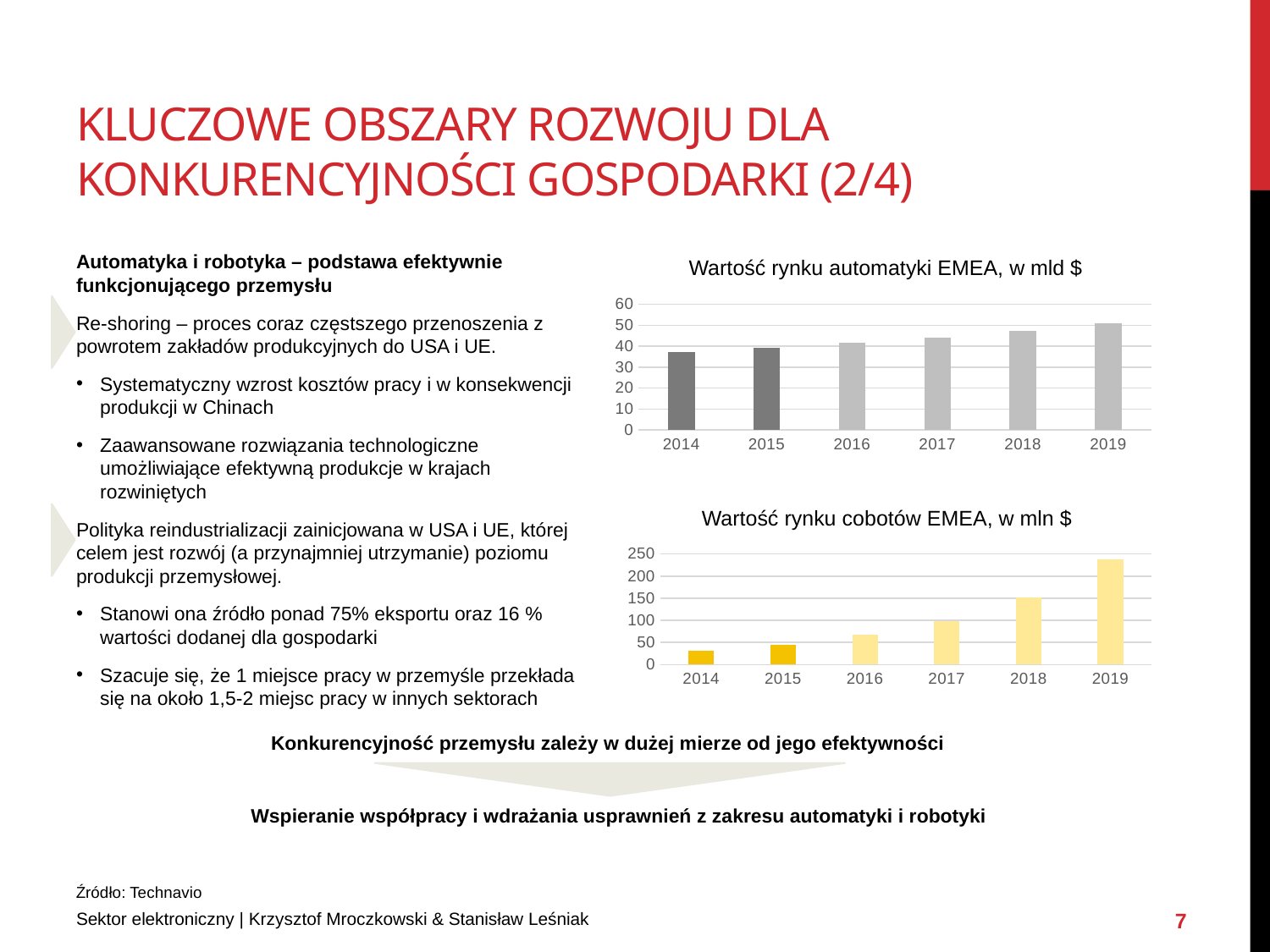
In the 'Wartość rynku automatyki EMEA, w mld $' chart, which year has the highest value? 2019 In the 'Wartość rynku cobotów EMEA, w mln $' chart, is the value for 2019 greater or less than 200? greater In the 'Wartość rynku automatyki EMEA, w mld $' chart, is the value for 2014 greater or less than 40? less In the 'Wartość rynku cobotów EMEA, w mln $' chart, is the value for 2014 greater or less than 50? less What kind of chart is the 'Wartość rynku automatyki EMEA, w mld $' chart? bar chart What is the title of the lower chart on the slide? Wartość rynku cobotów EMEA, w mln $ In the 'Wartość rynku automatyki EMEA, w mld $' chart, do the values rise or fall from 2014 to 2019? rise In the 'Wartość rynku cobotów EMEA, w mln $' chart, which year has the highest value? 2019 In the 'Wartość rynku cobotów EMEA, w mln $' chart, which is larger, the value for 2018 or the value for 2016? 2018 In the 'Wartość rynku automatyki EMEA, w mld $' chart, which year has the lowest value? 2014 How many years are shown on the x axis of the 'Wartość rynku automatyki EMEA, w mld $' chart? 6